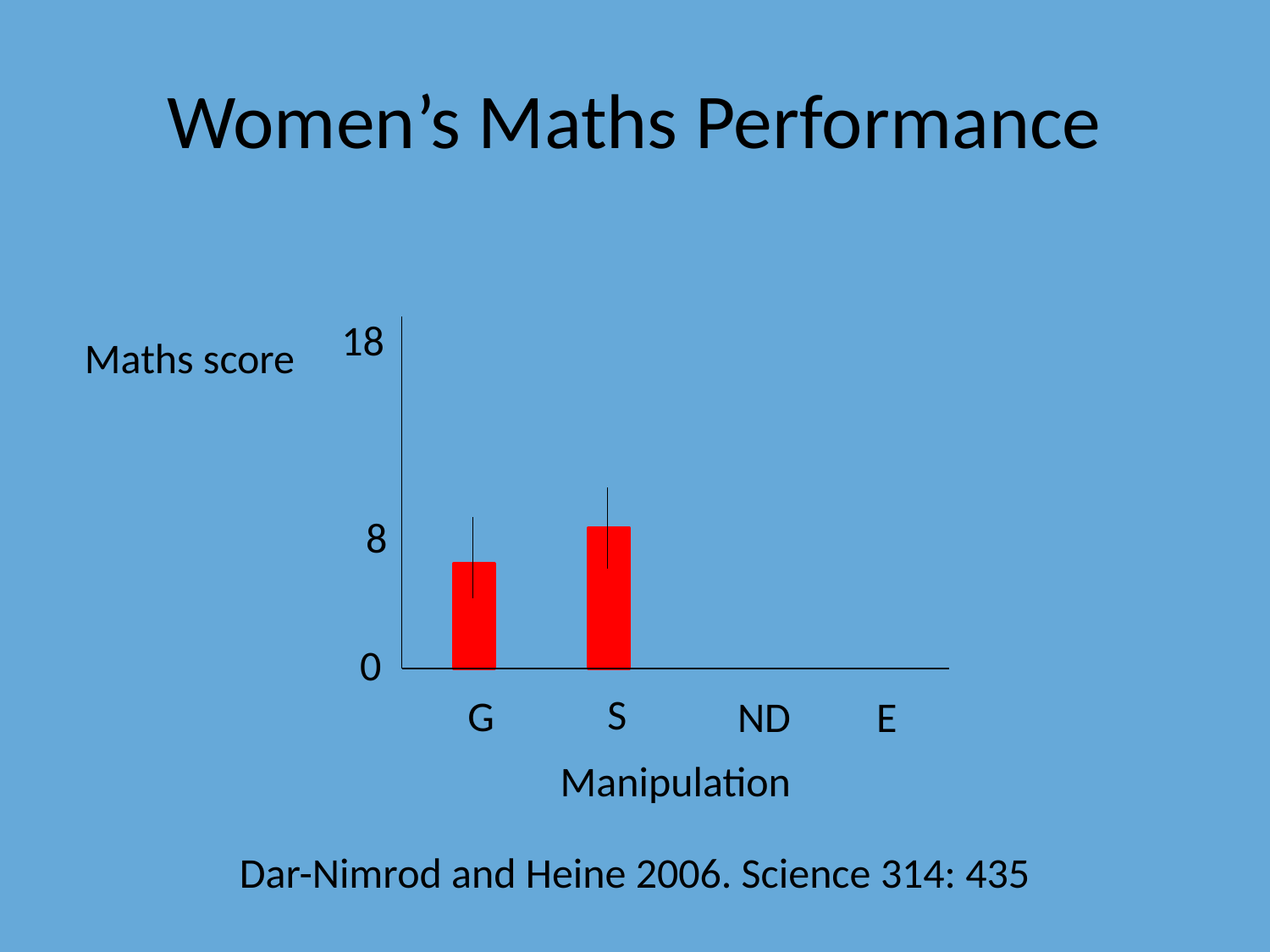
Is the value for S greater or less than 18? less How many bars are plotted on the chart? 2 What kind of chart is shown on the slide? bar chart Which category has the tallest bar? S Is the value for G greater or less than 8? less How many categories are labelled on the x axis? 4 What is the label on the x axis of the chart? Manipulation Which categories on the x axis have no bar plotted? ND and E Which of the two plotted bars is larger, G or S? S What is the title of the chart? Women's Maths Performance